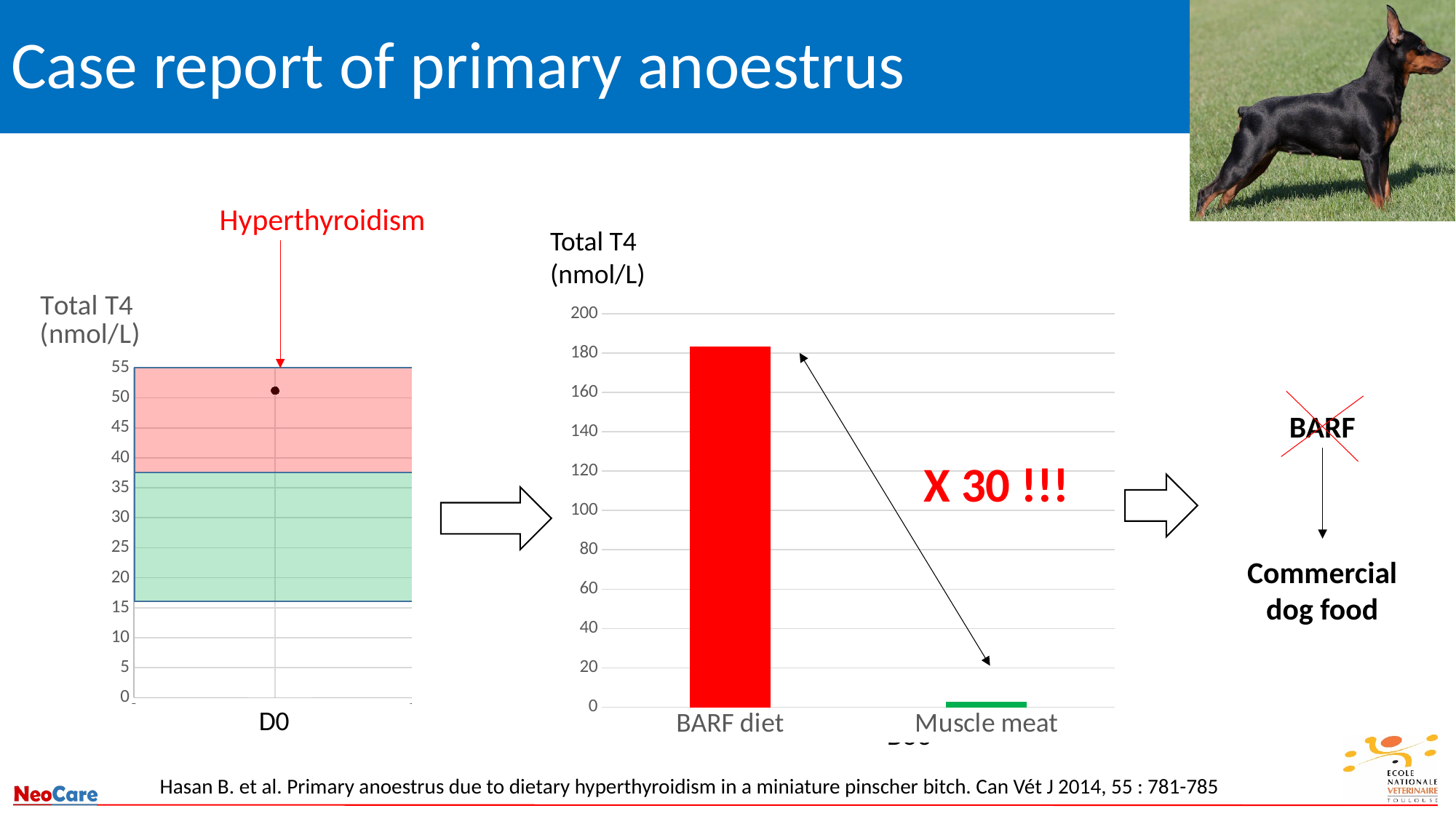
In the right-hand bar chart, is the value for Muscle meat greater or less than 20? less In the right-hand bar chart, which category has the lowest Total T4 value? Muscle meat In the right-hand bar chart, what is the highest value shown on the y axis? 200 What kind of chart is the right-hand chart comparing BARF diet and Muscle meat? bar chart In the right-hand bar chart, how many categories are shown on the x axis? 2 In the right-hand bar chart, is the value for BARF diet greater or less than 160? greater In the right-hand bar chart, which category has the highest Total T4 value? BARF diet In the right-hand bar chart, which is larger, the value for BARF diet or the value for Muscle meat? BARF diet In the left-hand chart, is the plotted value at D0 greater or less than 45? greater In the right-hand bar chart, what colour is the BARF diet bar? red In the left-hand chart, what is the label of the single category on the x axis? D0